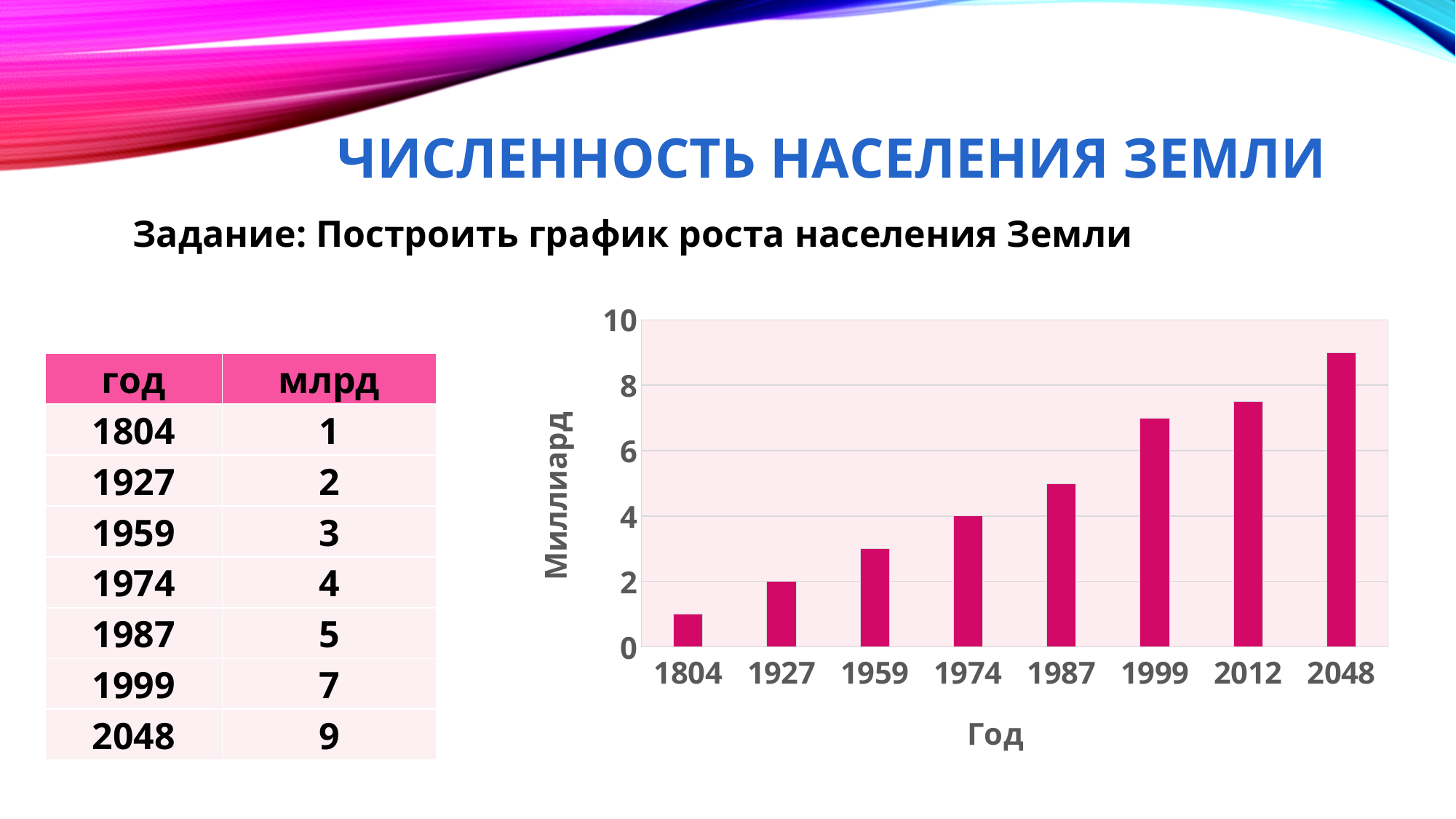
Which is larger, the value for 1999 or the value for 1987? 1999 Is the value for 1959 greater or less than 4? less What is the difference between the values for 1974 and 1927? 2 What is the value for 1927 in the chart? 2 How many bars (years) are plotted in the chart? 8 Is the value for 2012 greater or less than 6? greater What is the value for 1974 in the chart? 4 What is the label on the vertical axis of the chart? Миллиард Which year has the lowest bar in the chart? 1804 Do the values rise or fall from left to right along the x axis? rise What kind of chart is shown on the slide? bar chart Which year has the highest bar in the chart? 2048